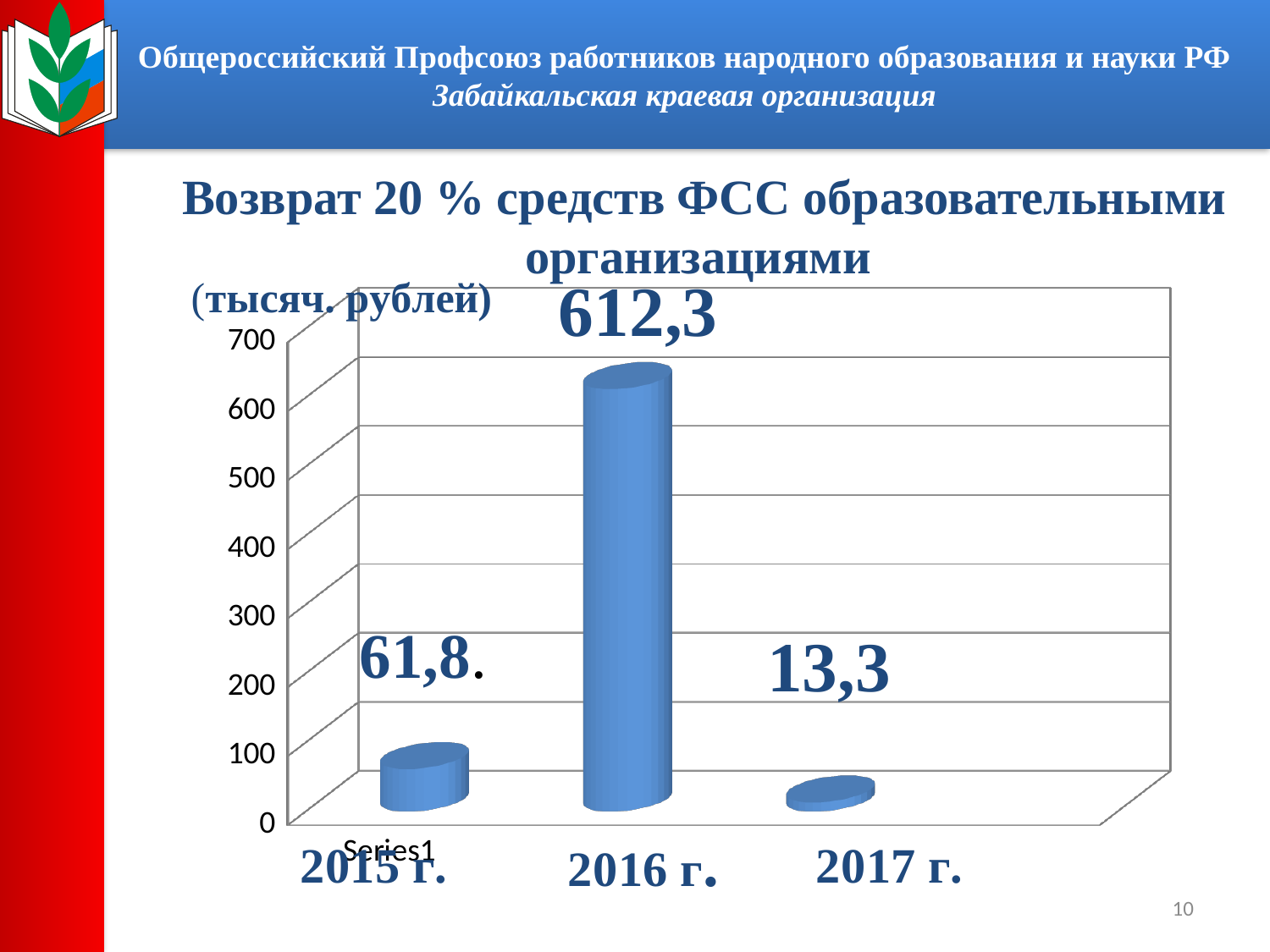
Which year has the lowest value? 2017 г. What is the difference between the values for 2016 г. and 2015 г.? 550,5 Which is larger, the value for 2015 г. or the value for 2017 г.? 2015 г. What is the value for 2016 г.? 612,3 In what units are the chart values given, according to the title? тысяч. рублей What is the difference between the values for 2015 г. and 2017 г.? 48,5 Is the value for 2016 г. greater or less than 600? greater Which year has the highest value? 2016 г. What is the value for 2015 г.? 61,8 What kind of chart is shown on the slide? bar chart What is the value for 2017 г.? 13,3 How many years are shown on the chart? 3